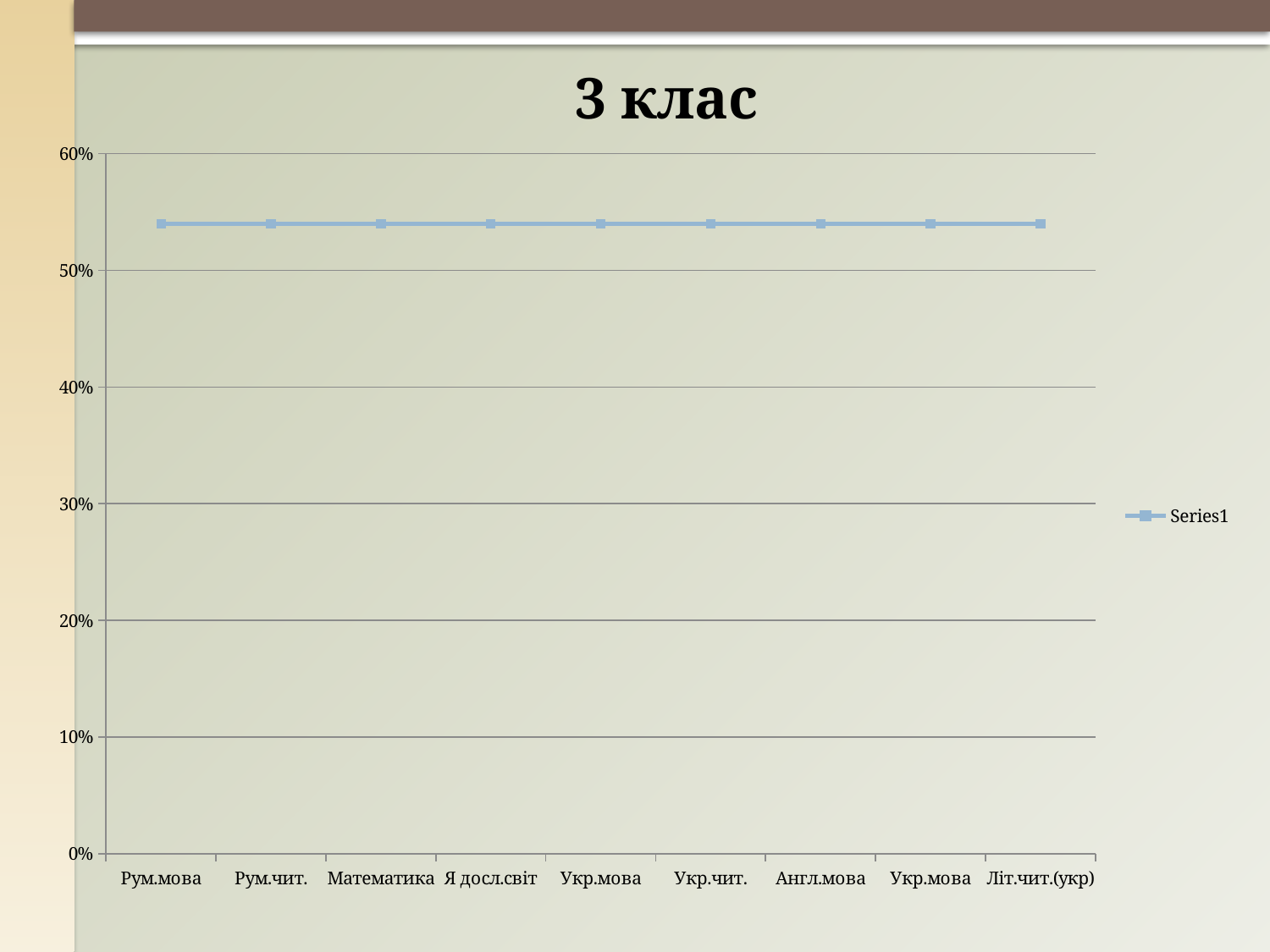
Do the values rise, fall, or stay flat across the categories on the x axis? stay flat How many series does the legend list? 1 Is the value for Літ.чит.(укр) greater or less than 50%? greater What kind of chart is shown on the slide? line chart Is the value for Я досл.світ greater or less than 60%? less What is the name of the series shown in the legend? Series1 What is the highest value shown on the vertical axis? 60% Is the value for Англ.мова greater or less than 40%? greater How many categories are shown on the x axis of the chart? 9 What is the title of the chart? 3 клас